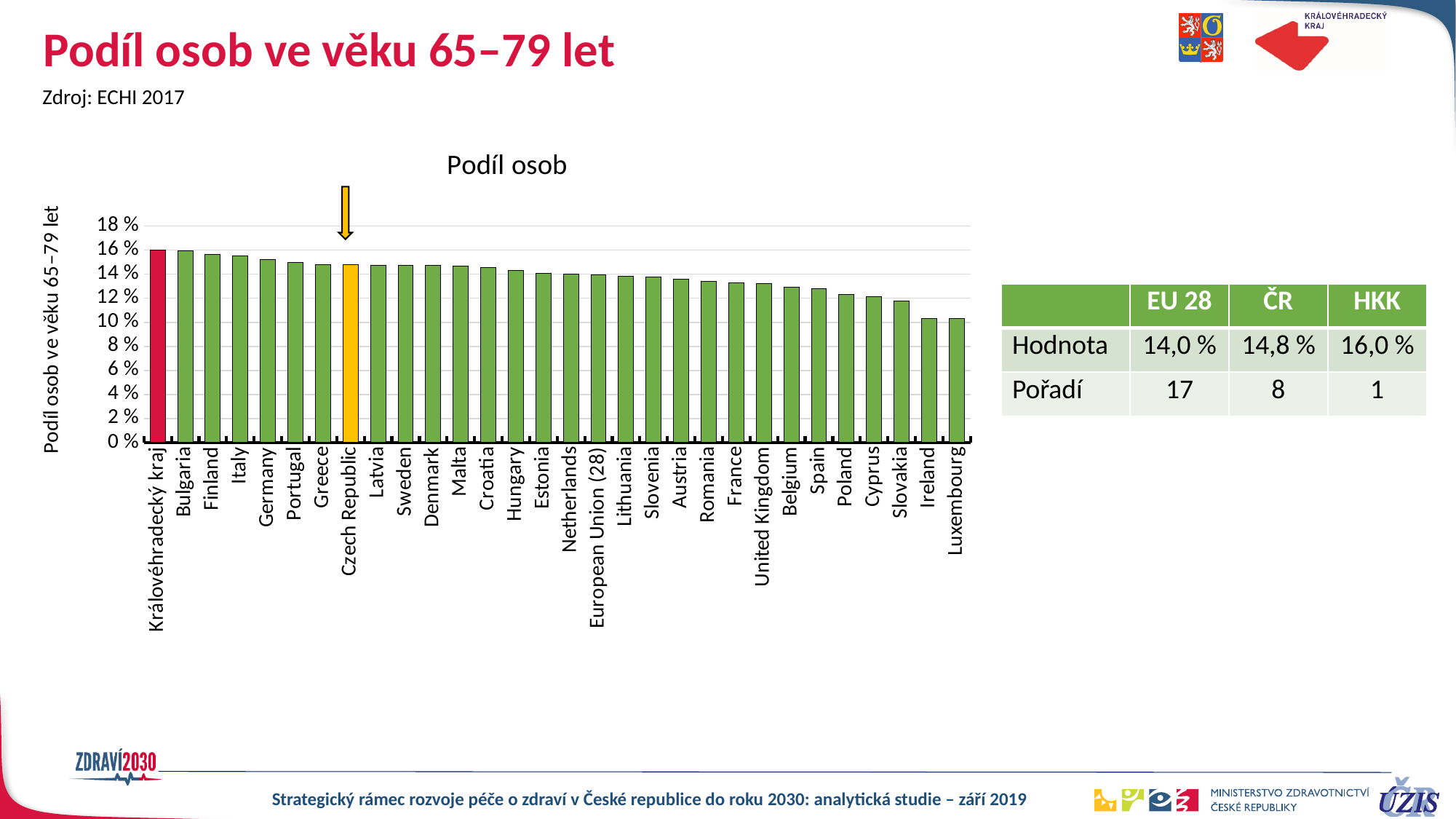
What is the value for Královéhradecký kraj (HKK)? 16,0 % What is the value for the European Union (28)? 14,0 % How many categories (bars) are shown in the chart? 30 Which category has the highest value in the chart? Královéhradecký kraj What is the difference between the value for Královéhradecký kraj and the value for EU 28? 2,0 % Is the value for Luxembourg greater or less than 12 %? less What is the difference between the value for Královéhradecký kraj and the value for the Czech Republic? 1,2 % Do the values rise or fall from left to right along the x axis? fall Which is larger, the value for Bulgaria or the value for Luxembourg? Bulgaria What kind of chart is shown on the slide? bar chart Is the value for Bulgaria greater or less than 14 %? greater What is the value for the Czech Republic (ČR)? 14,8 %